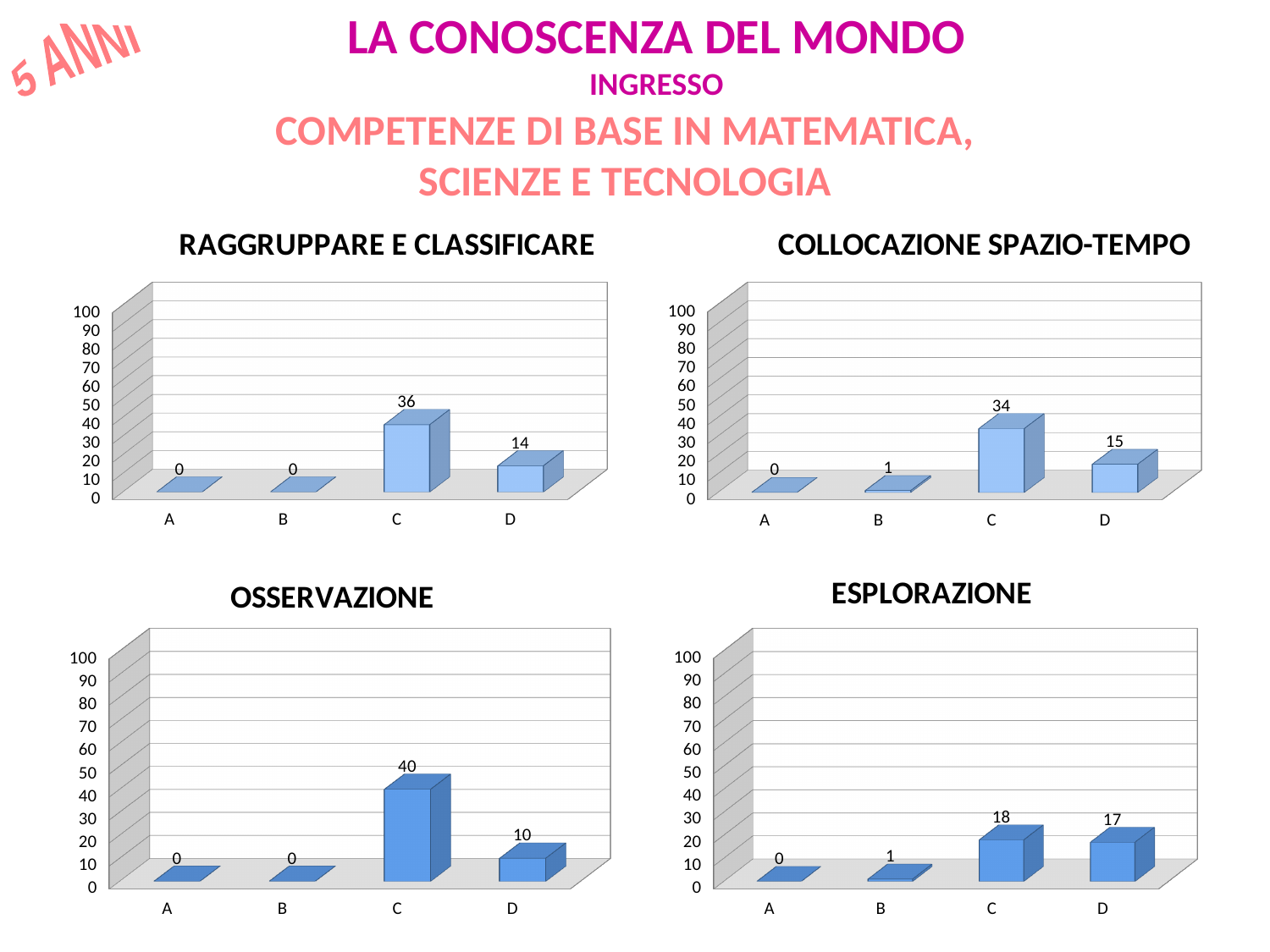
In the OSSERVAZIONE chart, which category has the highest value? C In the RAGGRUPPARE E CLASSIFICARE chart, is the value for C greater or less than 30? greater In the RAGGRUPPARE E CLASSIFICARE chart, what is the value for C? 36 In the ESPLORAZIONE chart, what is the value for B? 1 In the ESPLORAZIONE chart, what is the difference between the values for C and D? 1 In the COLLOCAZIONE SPAZIO-TEMPO chart, what is the value for D? 15 How many categories are shown in the ESPLORAZIONE chart? 4 In the COLLOCAZIONE SPAZIO-TEMPO chart, what is the value for A? 0 How many charts are on the slide? 4 In the COLLOCAZIONE SPAZIO-TEMPO chart, which is larger, the value for C or the value for D? C In the OSSERVAZIONE chart, what is the difference between the values for C and D? 30 What kind of chart is the OSSERVAZIONE chart? bar chart